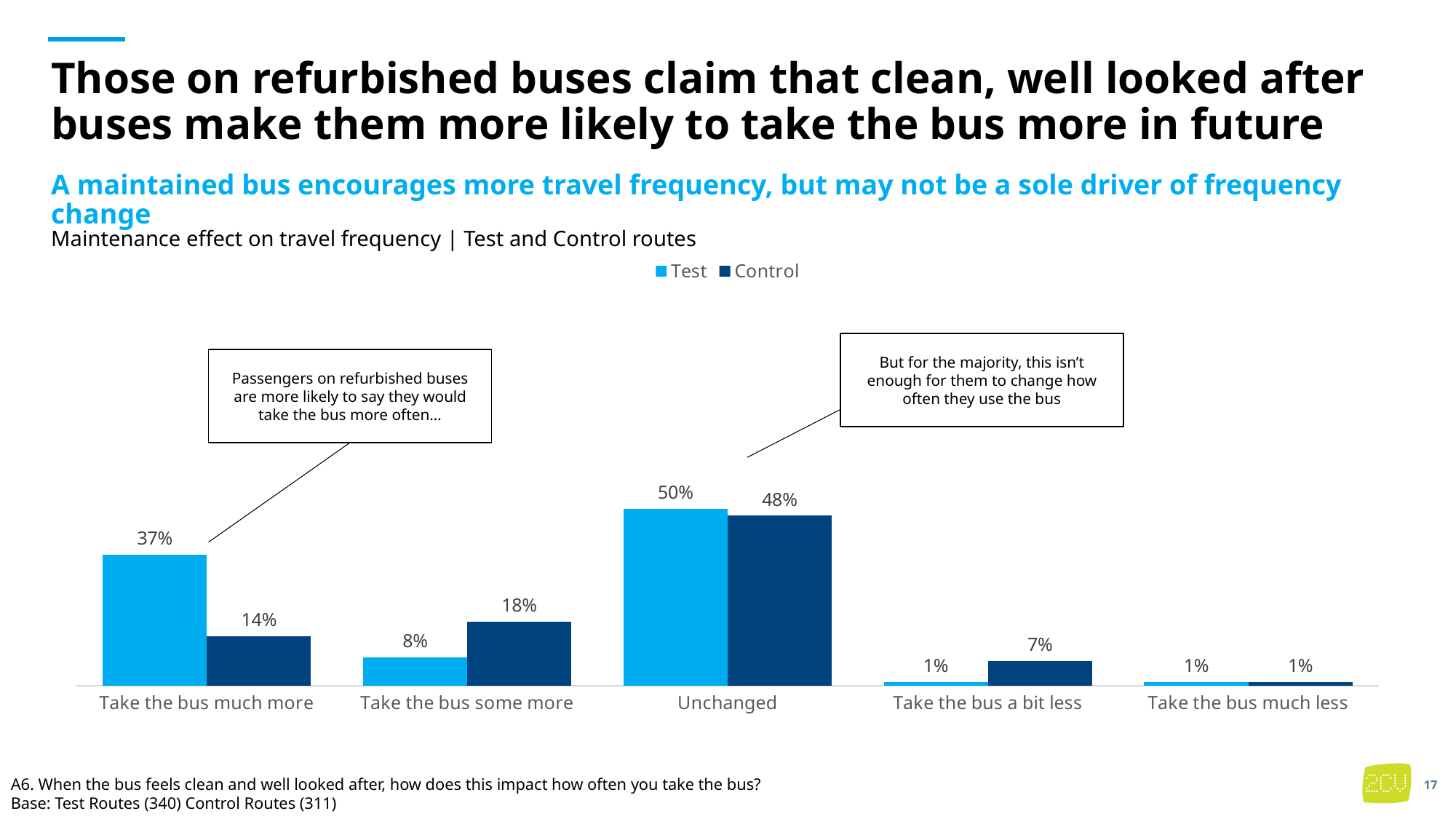
How many series does the legend list? 2 What is the Control value for "Unchanged"? 48% What is the chart's title? Maintenance effect on travel frequency | Test and Control routes How many categories are shown on the x axis? 5 Which category has the lowest Control value? Take the bus much less For "Take the bus some more", which series has the larger value, Test or Control? Control What is the Test value for "Take the bus much more"? 37% Which category has the highest Test value? Unchanged What kind of chart is shown on the slide? Bar chart What is the Control value for "Take the bus some more"? 18% What is the Control value for "Take the bus a bit less"? 7% What is the difference between the Test and Control values for "Take the bus much more"? 23 percentage points